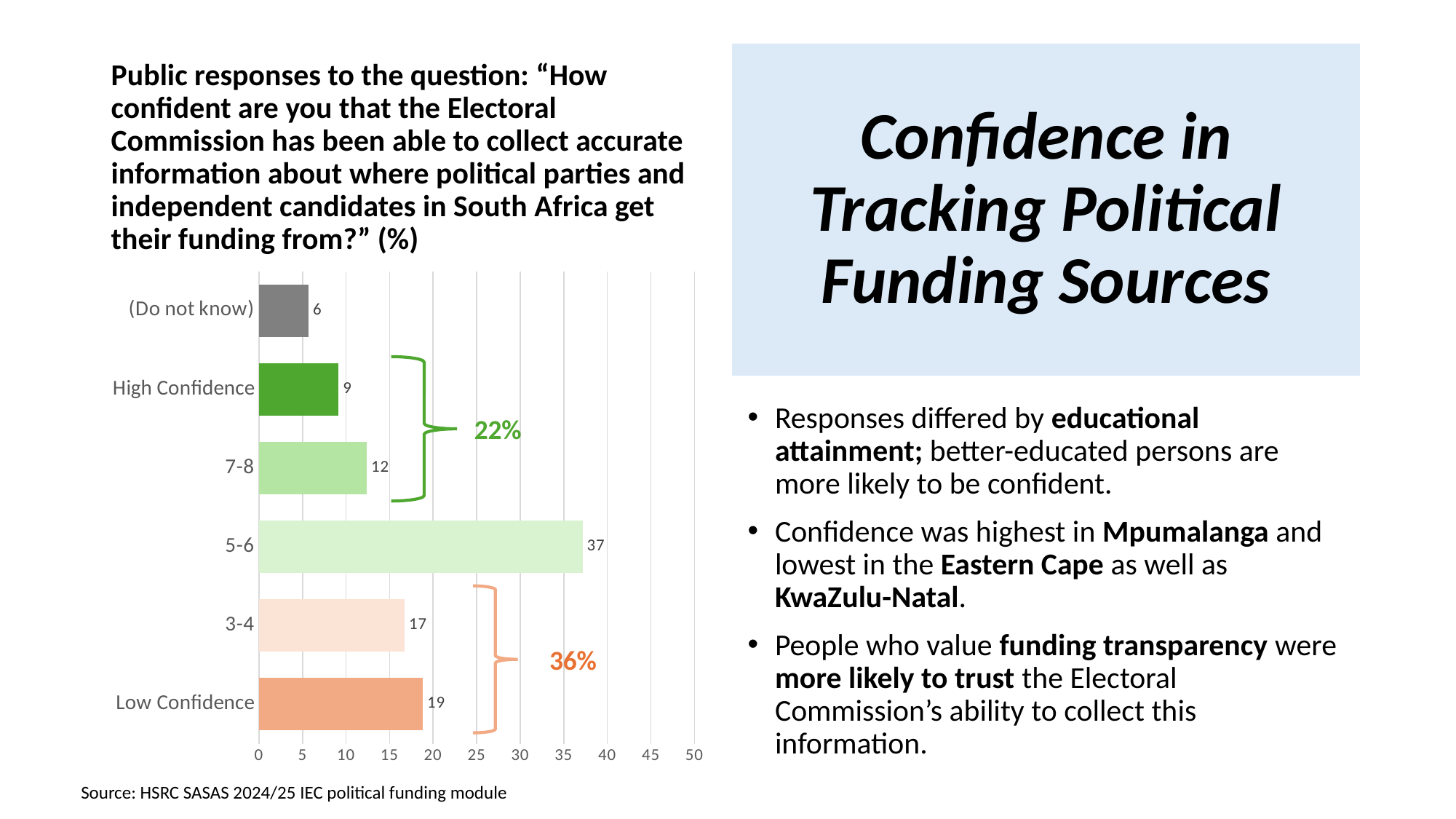
What is the value for the 5-6 category? 37 Which category has the highest value? 5-6 What combined percentage is shown by the green bracket for High Confidence and 7-8? 22% How many categories are shown in the chart? 6 What is the value for the (Do not know) category? 6 What is the difference between the values for 5-6 and 3-4? 20 What is the value for High Confidence? 9 Which category has the lowest value? (Do not know) What is the value for Low Confidence? 19 Which is larger, the value for 7-8 or the value for 3-4? 3-4 What combined percentage is shown by the orange bracket for 3-4 and Low Confidence? 36% What kind of chart is shown on the slide? Bar chart